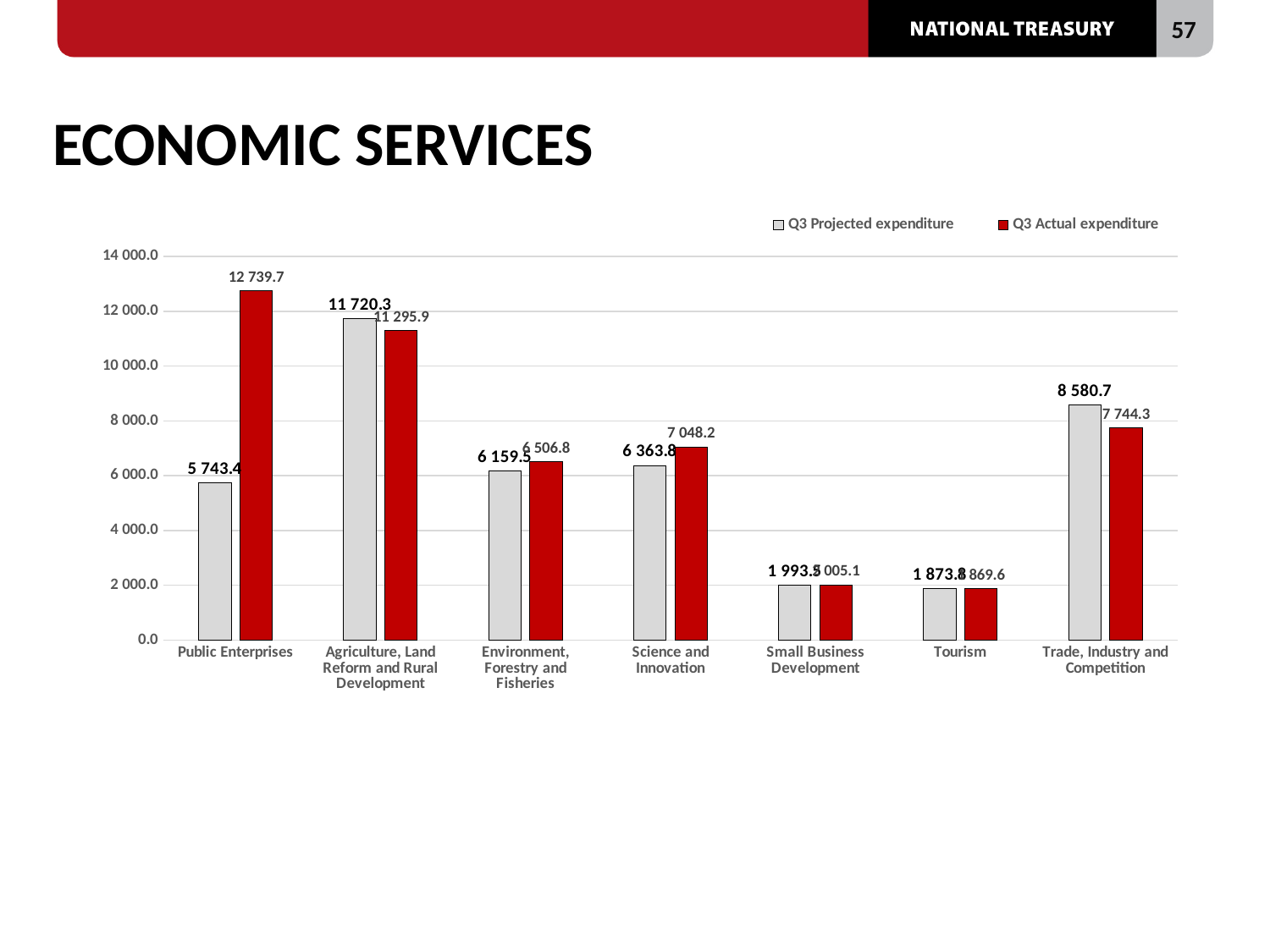
What is the Q3 Projected expenditure for Agriculture, Land Reform and Rural Development? 11 720.3 For Science and Innovation, which is larger: Q3 Projected expenditure or Q3 Actual expenditure? Q3 Actual expenditure What is the difference between the Q3 Projected and Q3 Actual expenditure for Trade, Industry and Competition? 836.4 How many series does the legend list? 2 Which category has the highest Q3 Actual expenditure? Public Enterprises Is the Q3 Projected expenditure for Trade, Industry and Competition greater or less than 8 000.0? greater By how much does the Q3 Actual expenditure for Public Enterprises exceed its Q3 Projected expenditure? 6 996.3 What is the Q3 Actual expenditure for Trade, Industry and Competition? 7 744.3 What is the Q3 Actual expenditure for Public Enterprises? 12 739.7 Which category has the highest Q3 Projected expenditure? Agriculture, Land Reform and Rural Development How many categories are shown on the x axis of the chart? 7 For Agriculture, Land Reform and Rural Development, which is larger: Q3 Projected expenditure or Q3 Actual expenditure? Q3 Projected expenditure